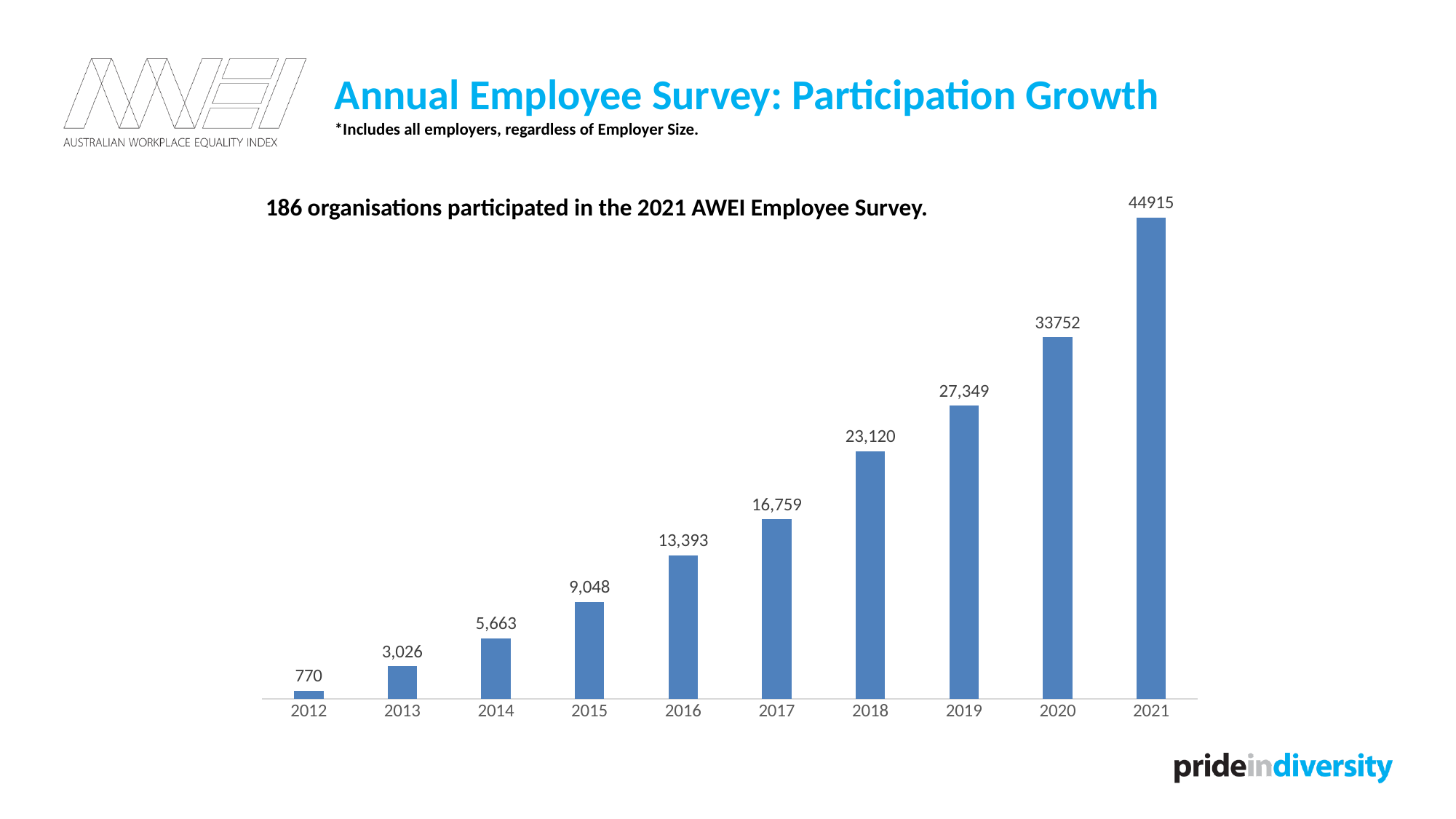
What is the difference between the values for 2015 and 2014? 3,385 What is the value for 2016? 13,393 Which year has the highest value? 2021 What is the difference between the values for 2021 and 2020? 11163 Do the values rise or fall from 2012 to 2021? Rise Which year has the lowest value? 2012 How many years are shown on the x axis? 10 What is the value for 2012? 770 What kind of chart is shown on the slide? Bar chart What is the value for 2019? 27,349 Which is larger, the value for 2017 or the value for 2018? 2018 What is the value for 2021? 44915